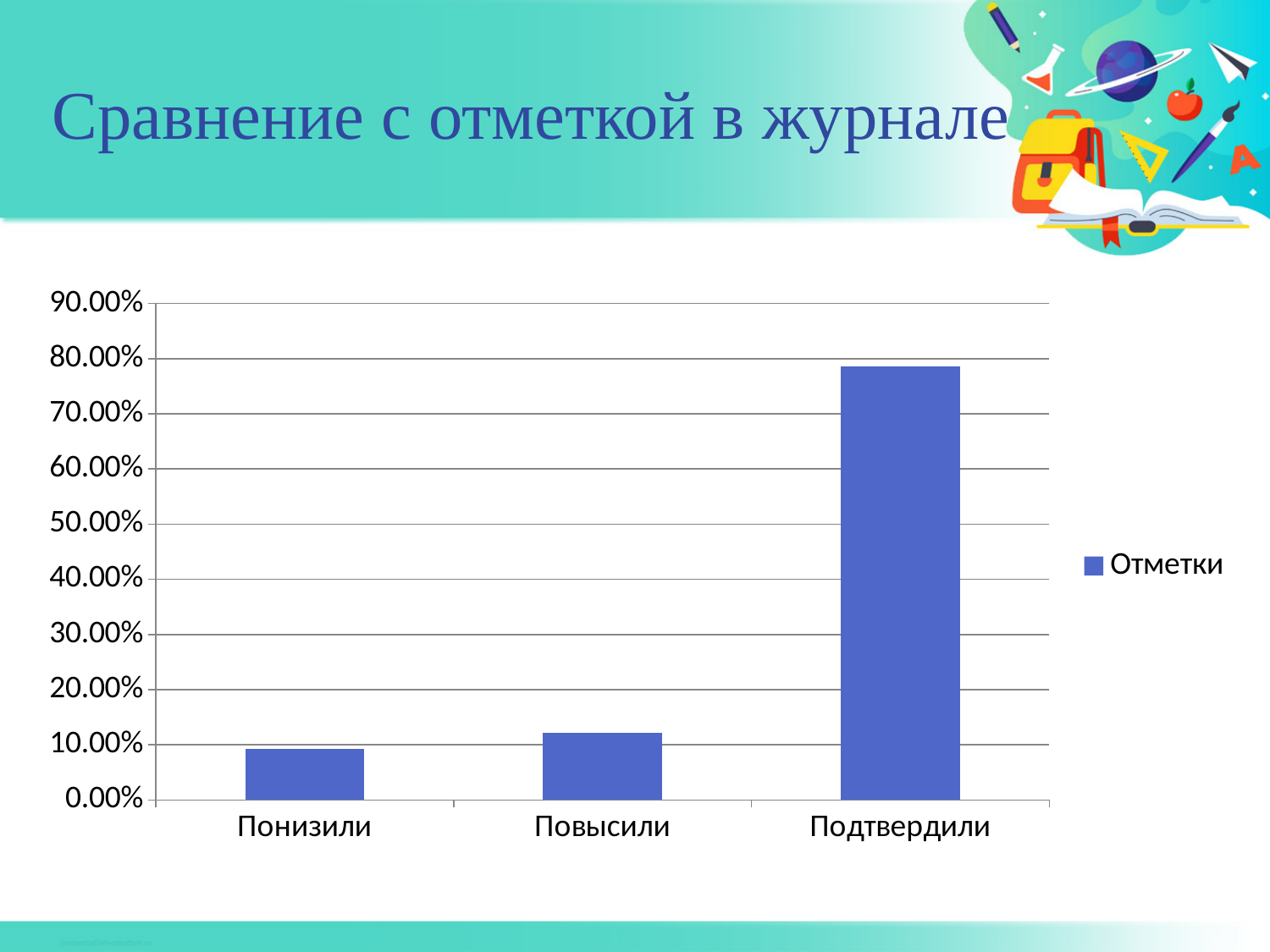
Is the value for Подтвердили greater or less than 80.00%? less Is the value for Подтвердили greater or less than 70.00%? greater Which is larger, the value for Понизили or the value for Повысили? Повысили Which category has the highest value in the chart? Подтвердили Is the value for Повысили greater or less than 20.00%? less How many series does the chart legend list? 1 What kind of chart is shown on the slide? bar chart Which category has the lowest value in the chart? Понизили What is the name of the series shown in the chart legend? Отметки How many categories are shown on the x axis of the chart? 3 What is the title of the slide containing the chart? Сравнение с отметкой в журнале